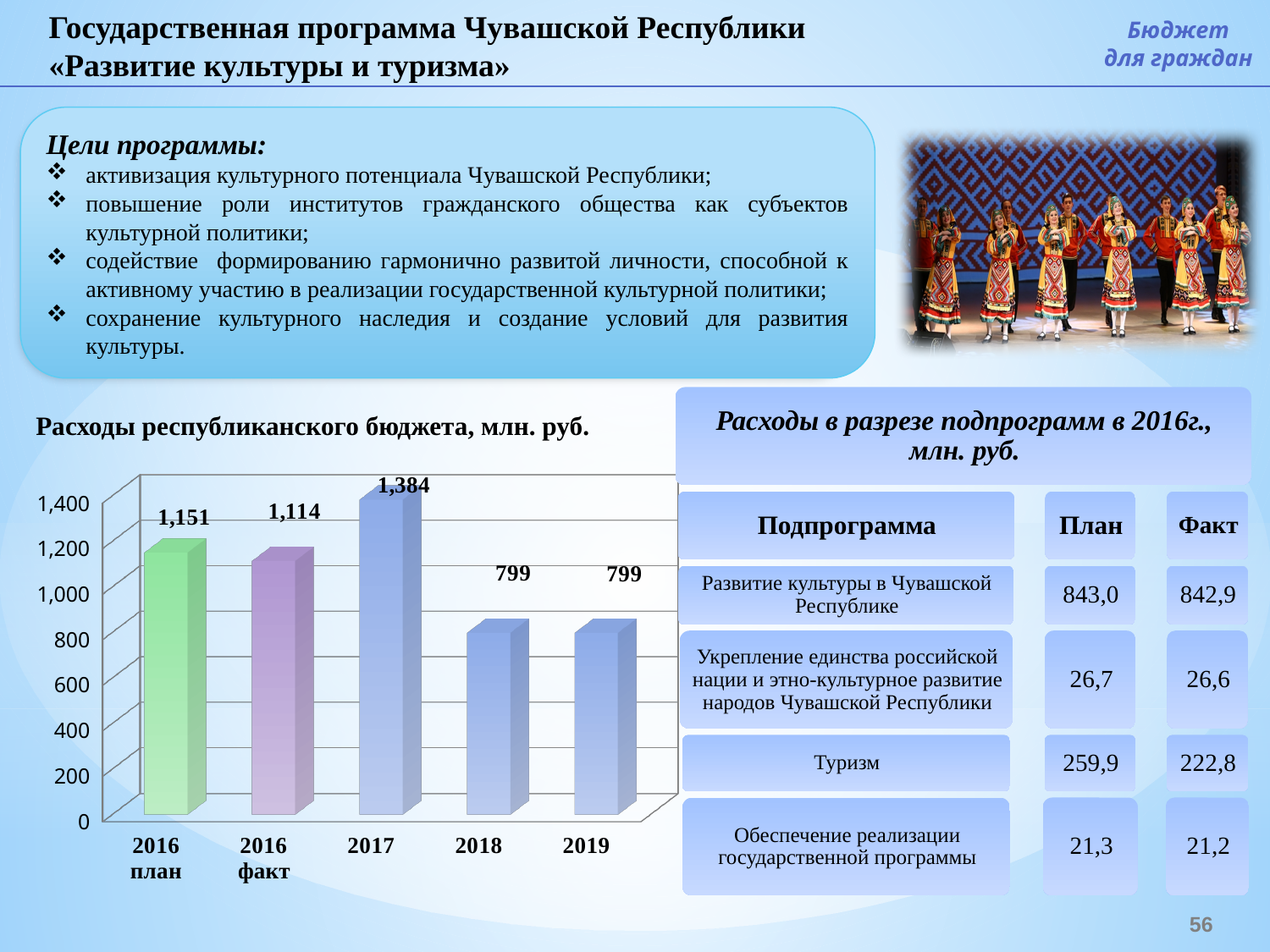
What is the value for 2017 in the chart "Расходы республиканского бюджета, млн. руб."? 1,384 What kind of chart is "Расходы республиканского бюджета, млн. руб."? bar chart What is the difference between the 2016 план and 2016 факт values in the chart "Расходы республиканского бюджета, млн. руб."? 37 What is the value for 2016 факт in the chart "Расходы республиканского бюджета, млн. руб."? 1,114 What is the value for 2018 in the chart "Расходы республиканского бюджета, млн. руб."? 799 Is the value for 2019 in the chart "Расходы республиканского бюджета, млн. руб." greater or less than 1,000? less Do the values in the chart "Расходы республиканского бюджета, млн. руб." rise or fall from 2017 to 2018? fall What is the difference between the 2017 and 2018 values in the chart "Расходы республиканского бюджета, млн. руб."? 585 Which is larger in the chart "Расходы республиканского бюджета, млн. руб.": the value for 2016 план or the value for 2016 факт? 2016 план How many categories are shown on the x axis of the chart "Расходы республиканского бюджета, млн. руб."? 5 Which category has the highest value in the chart "Расходы республиканского бюджета, млн. руб."? 2017 What is the value for 2016 план in the chart "Расходы республиканского бюджета, млн. руб."? 1,151